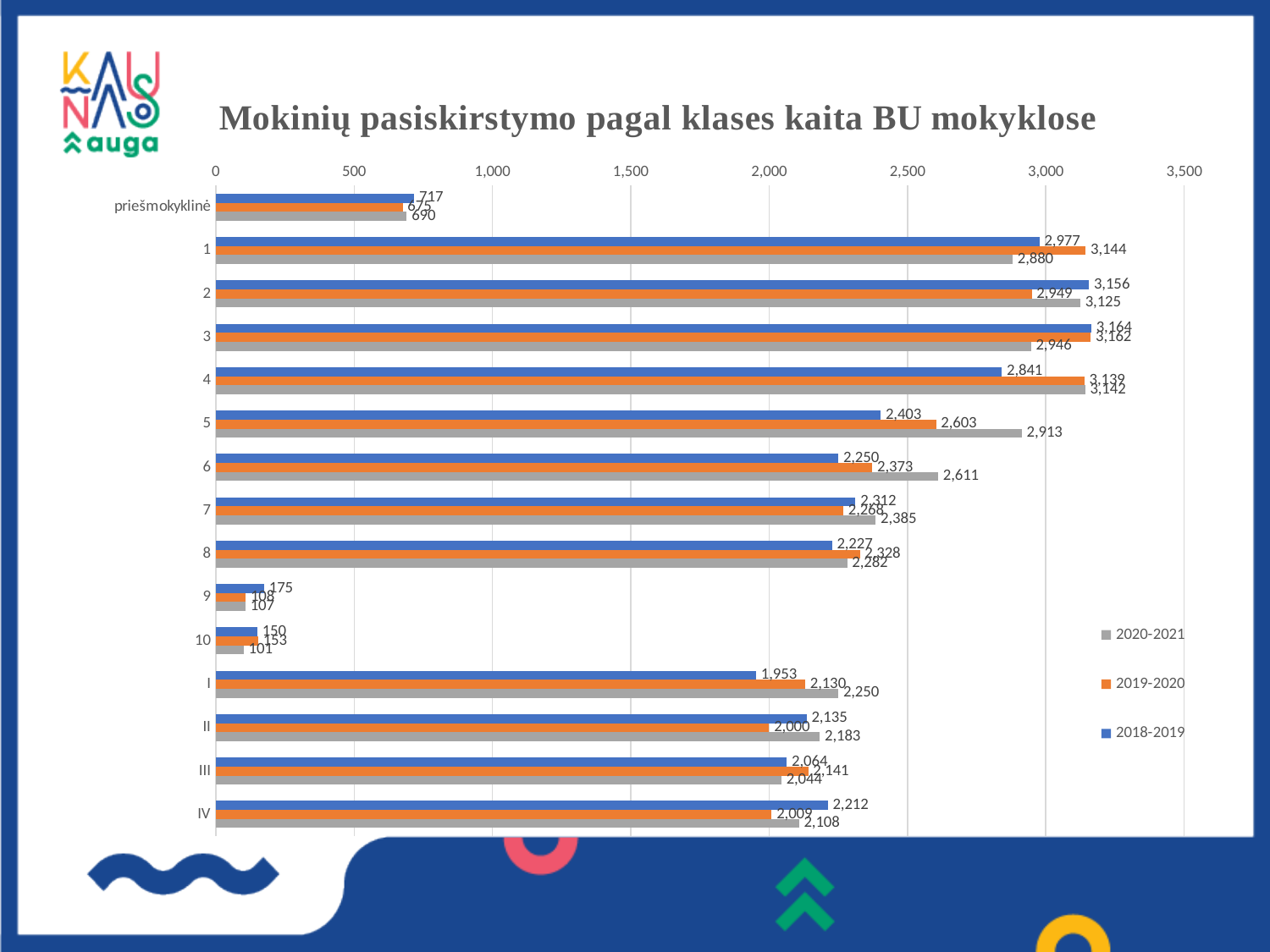
How many class categories are plotted on the chart? 15 What is the 2020-2021 value for class 5? 2,913 What kind of chart is shown on the slide? bar chart For class 6, which is larger: the 2019-2020 value or the 2020-2021 value? 2020-2021 How many series does the legend list? 3 What is the 2019-2020 value for class 1? 3,144 For class 5, what is the difference between the 2020-2021 value and the 2018-2019 value? 510 Which category has the lowest 2020-2021 value? 10 Is the 2018-2019 value for class I greater or less than 2,000? less What is the 2020-2021 value for class IV? 2,108 Which category has the highest 2020-2021 value? 4 What is the 2018-2019 value for priešmokyklinė? 717